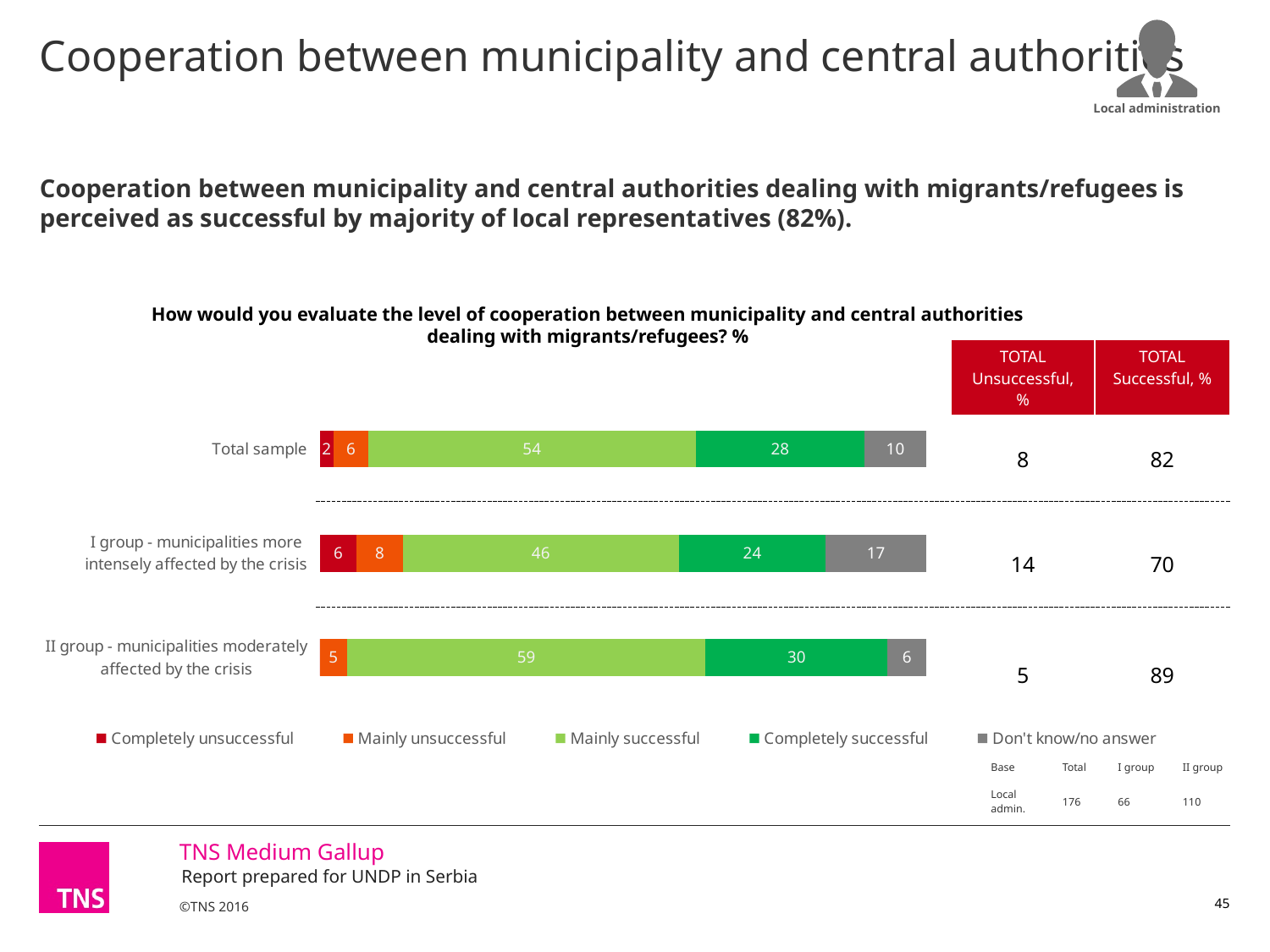
Which is larger: the 'Mainly unsuccessful' value for the Total sample or for the I group? I group What is the 'Don't know/no answer' value for the I group - municipalities more intensely affected by the crisis? 17 What is the 'Completely unsuccessful' value for the I group - municipalities more intensely affected by the crisis? 6 How many series does the chart legend list? 5 Which category has the lowest 'Completely successful' value? I group - municipalities more intensely affected by the crisis Which series is shown in orange in the chart? Mainly unsuccessful Which category has the highest 'Mainly successful' value? II group - municipalities moderately affected by the crisis What type of chart is shown on the slide? stacked bar chart How many categories (bars) are plotted in the chart? 3 What is the 'Mainly successful' value for the Total sample? 54 What is the 'Completely successful' value for the II group - municipalities moderately affected by the crisis? 30 What is the difference between the 'Mainly successful' values for the II group and the I group? 13